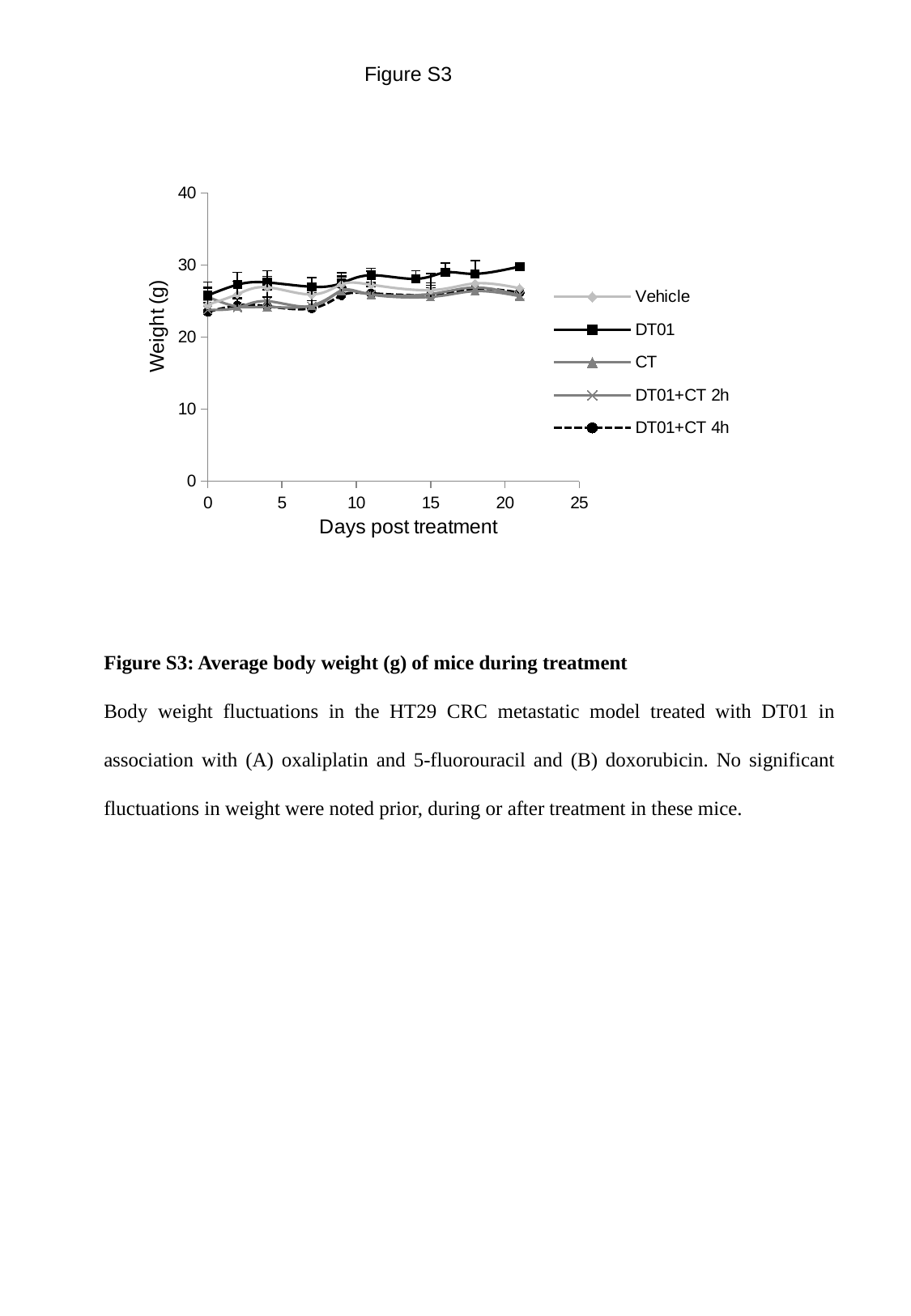
Is the weight for CT at day 0 greater or less than 20? greater At day 21, which is larger, the weight for DT01 or the weight for CT? DT01 What is the title of the y axis? Weight (g) How many series does the legend list? 5 What is the title of the x axis? Days post treatment Is the weight for Vehicle at day 21 greater or less than 30? less Is the weight for DT01 at day 21 greater or less than 20? greater How many data points are plotted for the DT01 series? 10 Which series has the highest weight at day 21? DT01 What kind of chart is shown on the slide? line chart Does the weight for DT01 rise or fall from day 0 to day 21? rise